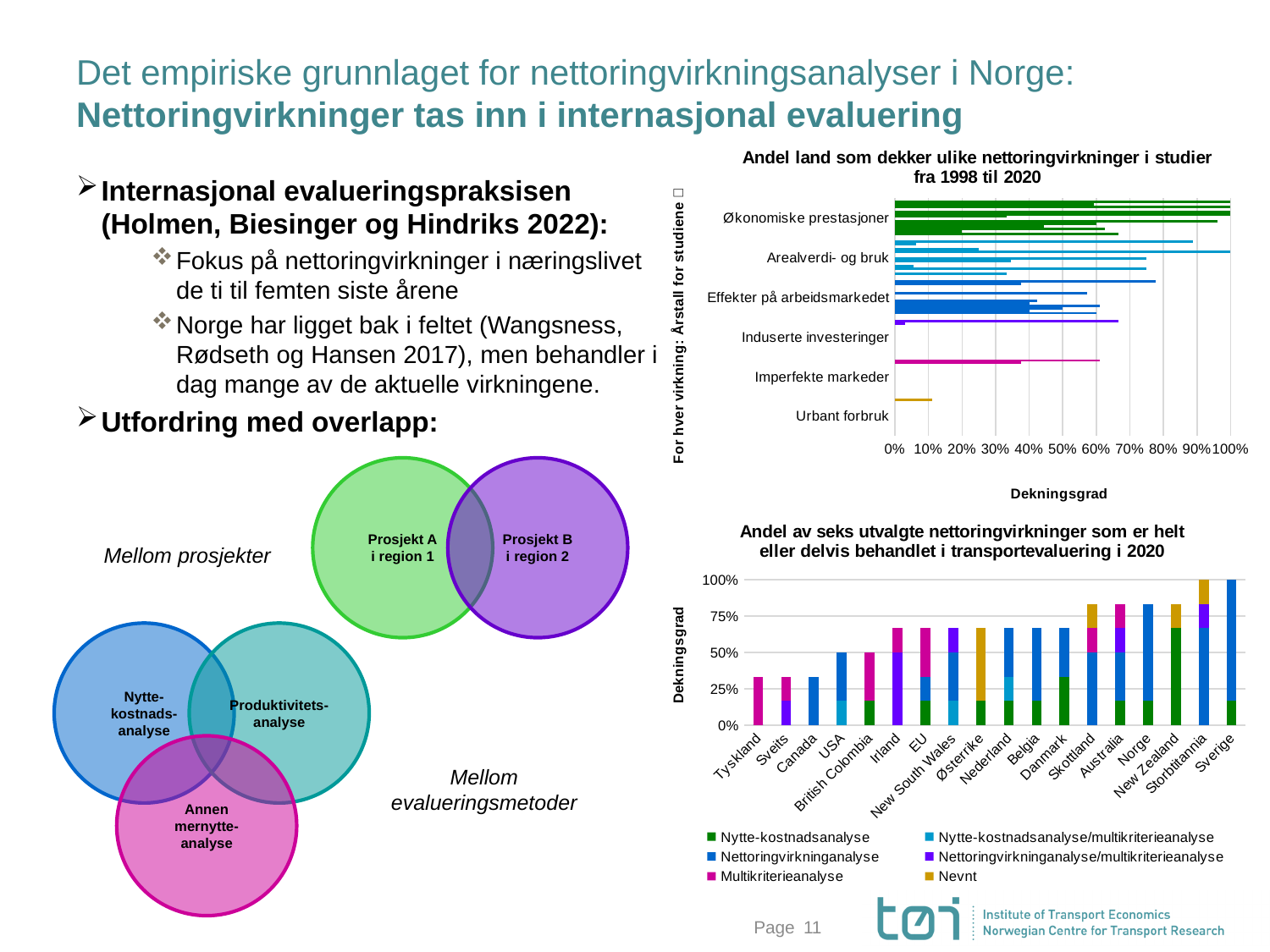
How many series does the legend of the bottom chart list? 6 In the top chart, how many categories of nettoringvirkninger are listed on the vertical axis? 6 In the bottom chart, is the total value for Tyskland greater or less than 50%? less In the bottom chart, is the total value for Norge greater or less than 75%? greater In the bottom chart, do the total values generally rise or fall from left to right along the x axis? rise In the top chart, which category has the shortest bars? Urbant forbruk In the bottom chart, what is the total value for Sverige? 100% What kind of chart is the bottom chart titled 'Andel av seks utvalgte nettoringvirkninger som er helt eller delvis behandlet i transportevaluering i 2020'? stacked bar chart In the bottom chart, how many countries or regions are shown on the x axis? 18 In the top chart, is the value for Urbant forbruk greater or less than 20%? less In the top chart, which category has the longest bars? Økonomiske prestasjoner What kind of chart is the top chart titled 'Andel land som dekker ulike nettoringvirkninger i studier fra 1998 til 2020'? bar chart